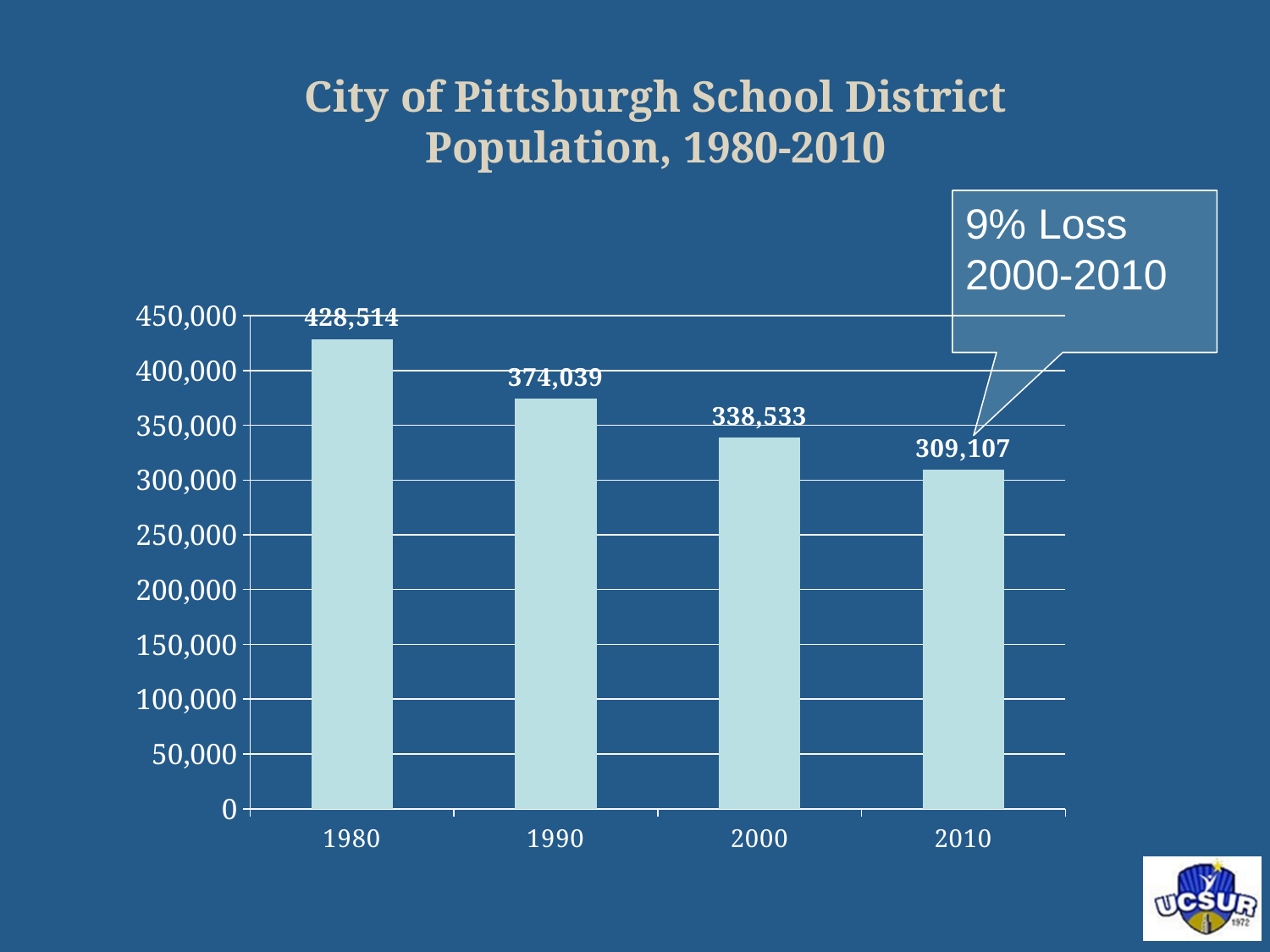
What was the City of Pittsburgh School District population in 1980? 428,514 Is the population in 2000 greater or less than 350,000? less What kind of chart is shown on the slide? bar chart What was the population in 2010? 309,107 What is the difference in population between 2000 and 2010? 29,426 What was the population in 1990? 374,039 How many years are shown on the x axis? 4 What is the difference in population between 1980 and 1990? 54,475 Which year had a larger population, 1990 or 2000? 1990 Does the population rise or fall from 1980 to 2010? fall Which year has the lowest population? 2010 Which year has the highest population? 1980